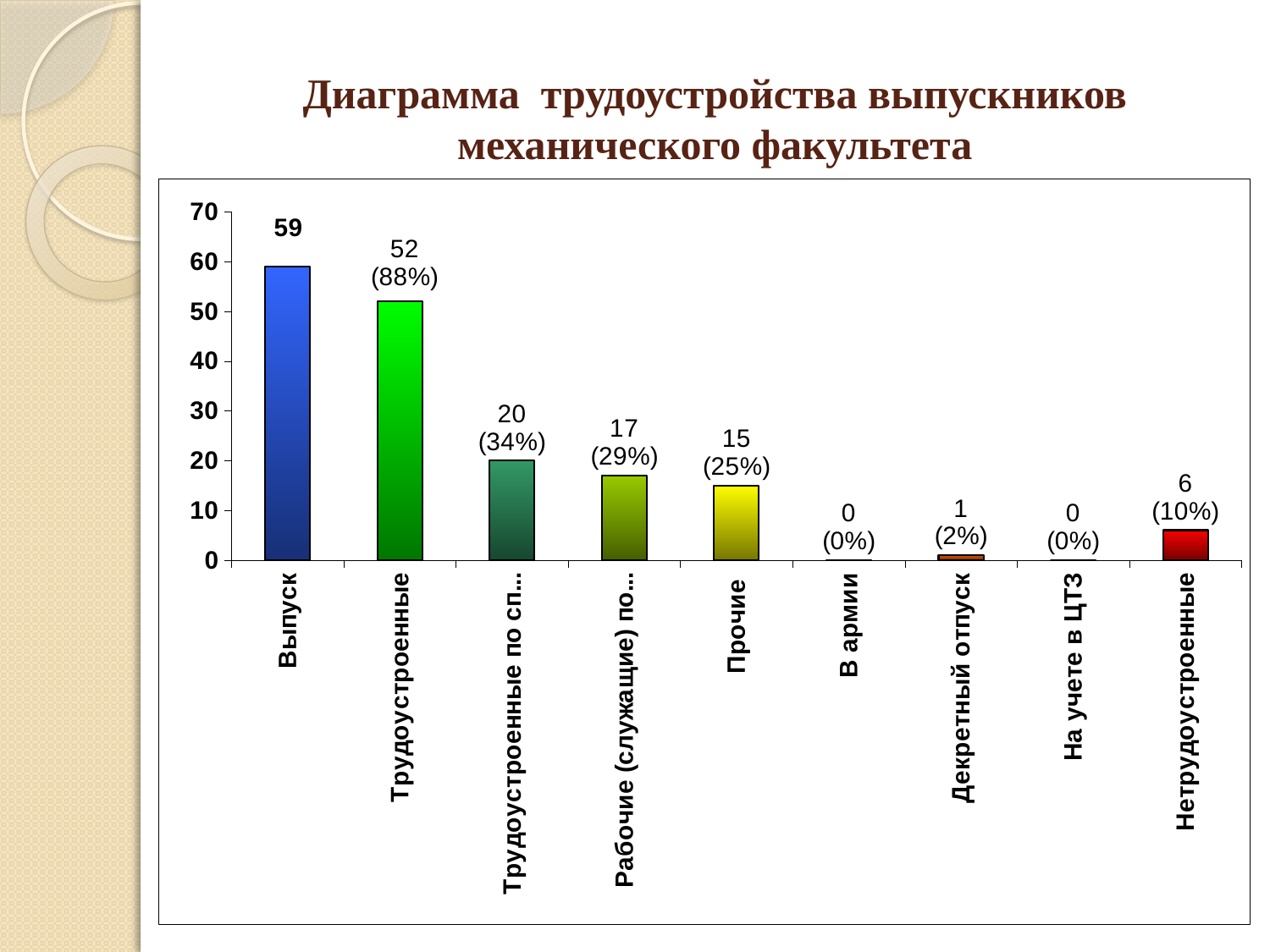
Which category has the highest value? Выпуск What is the value for Нетрудоустроенные? 6 Which is larger, the value for Прочие or the value for Нетрудоустроенные? Прочие How many categories are shown on the x axis? 9 What is the title of the slide? Диаграмма трудоустройства выпускников механического факультета What is the value for Прочие? 15 What percentage is shown for Декретный отпуск? 2% What type of chart is shown on the slide? bar chart What is the value for Выпуск? 59 What is the difference between the values for Выпуск and Трудоустроенные? 7 What percentage is shown for Трудоустроенные? 88% What is the value for Трудоустроенные? 52